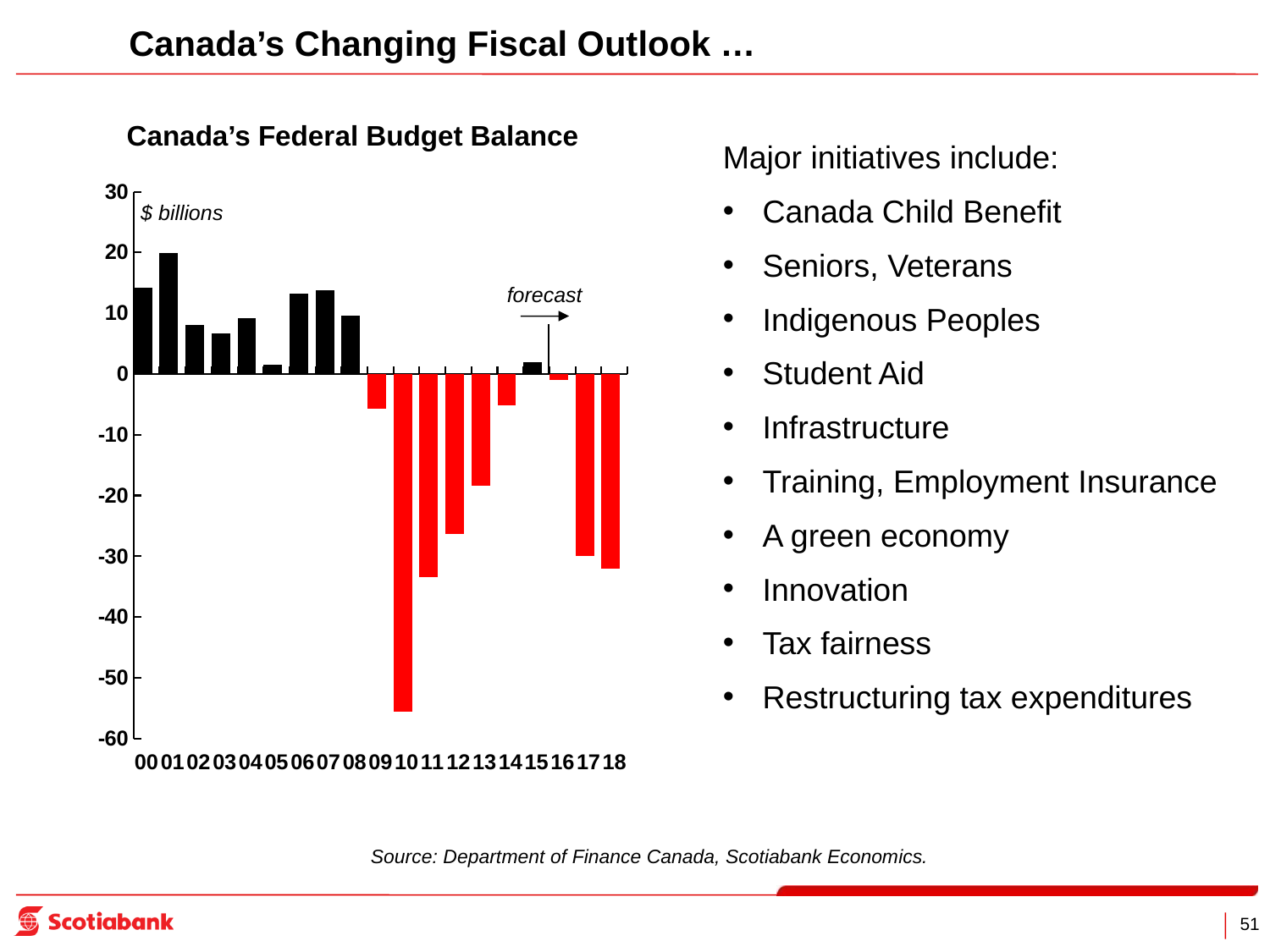
Is the value for 09 greater or less than -10? greater Which year has the highest federal budget balance in the chart? 01 What kind of chart is used to show Canada's Federal Budget Balance? bar chart What label marks the years at the right end of the chart that are projections? forecast Is the value for 11 greater or less than -30? less Is the value for 01 greater or less than 10? greater What unit is the budget balance measured in, according to the chart? $ billions Which year has the lowest federal budget balance in the chart? 10 Which year has the larger budget balance, 13 or 12? 13 Which year has the larger budget balance, 06 or 05? 06 How many years are shown on the x axis of the Canada's Federal Budget Balance chart? 19